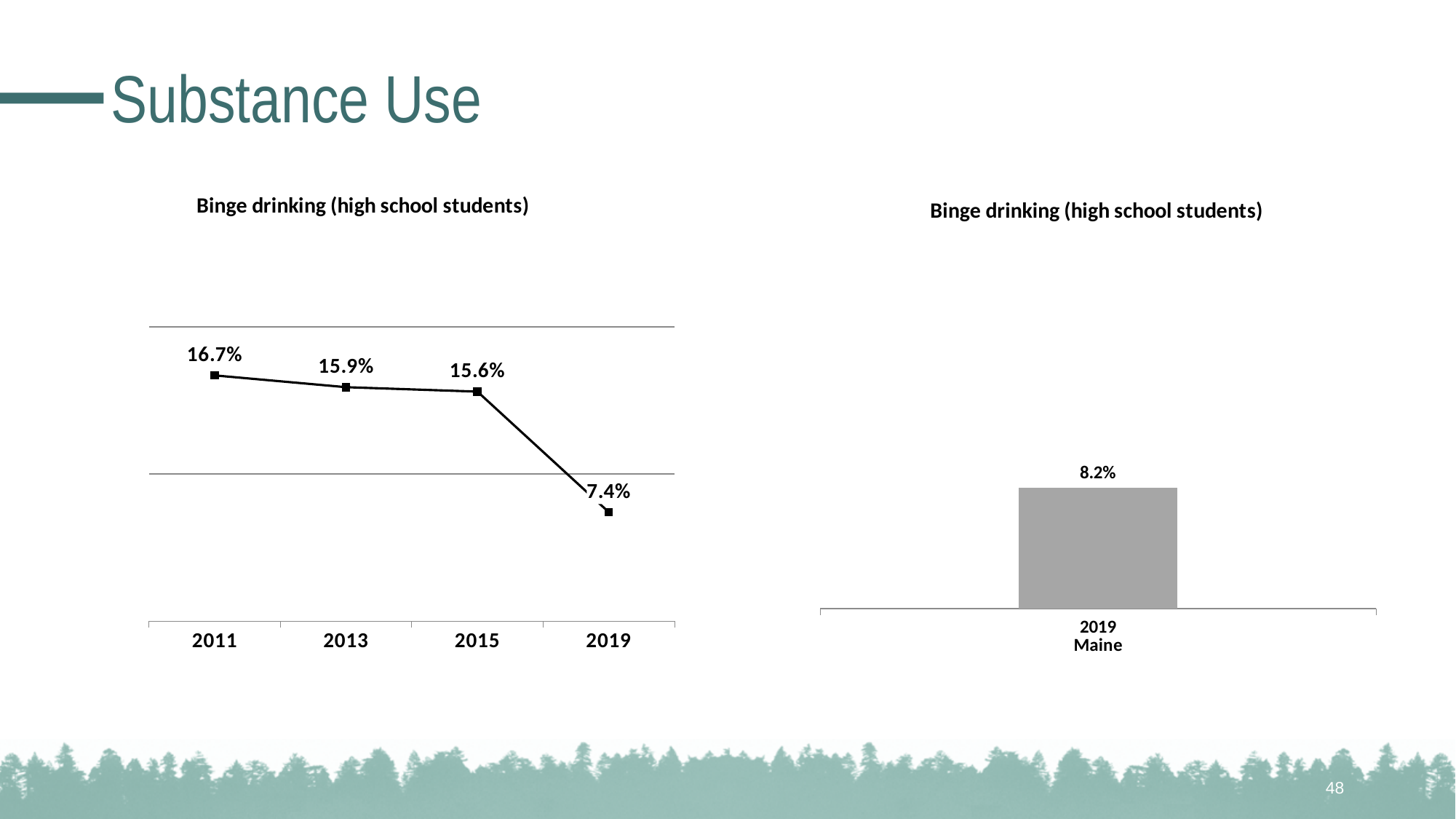
In the left chart (Binge drinking, high school students), which year has the lowest value? 2019 In the left chart (Binge drinking, high school students), which year has the highest value? 2011 In the left chart (Binge drinking, high school students), what is the value for 2015? 15.6% In the left chart (Binge drinking, high school students), what is the difference between the 2011 and 2019 values? 9.3% What kind of chart is the right chart (Binge drinking, high school students)? Bar chart How many data points are plotted in the left chart (Binge drinking, high school students)? 4 In the right chart (Binge drinking, high school students), what is the value for 2019 Maine? 8.2% In the left chart (Binge drinking, high school students), what is the value for 2011? 16.7% In the left chart (Binge drinking, high school students), what is the value for 2019? 7.4% Which is larger: the 2019 value in the left chart or the 2019 Maine value in the right chart? 2019 Maine (right chart) In the left chart (Binge drinking, high school students), what is the difference between the 2013 and 2015 values? 0.3% In the left chart (Binge drinking, high school students), do the values rise or fall from 2011 to 2019? Fall